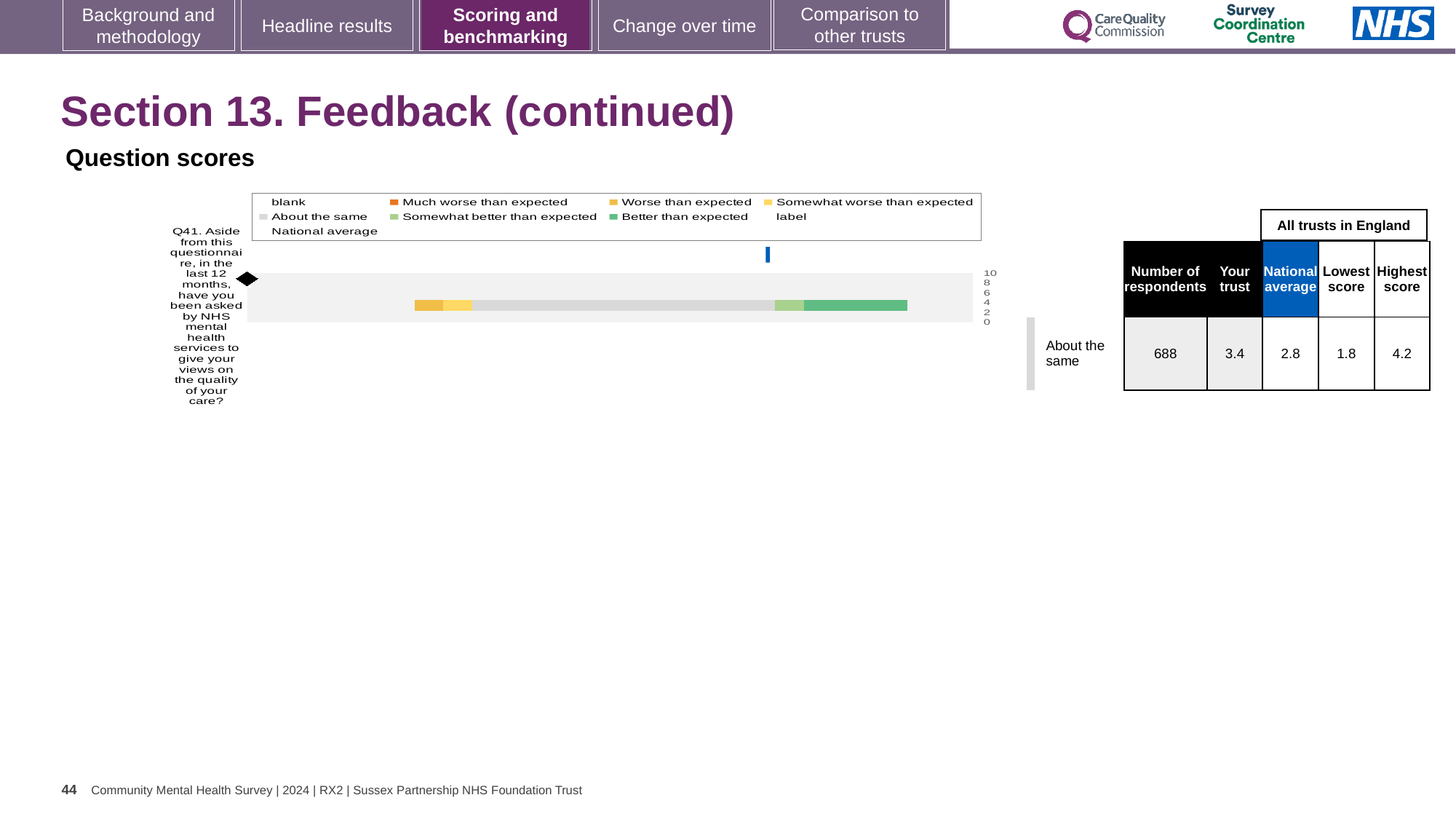
What kind of chart is shown on the slide? bar chart In the table next to the chart, what is the difference between the highest score and the lowest score for Q41? 2.4 Which legend category occupies the widest segment of the stacked bar? About the same In the table next to the chart, is the 'Your trust' score higher or lower than the national average for Q41? higher In the table next to the chart, how many respondents answered Q41? 688 In the table next to the chart, what is the national average score for Q41? 2.8 How many question categories are plotted in the bar chart? 1 Which question number is plotted in the bar chart? Q41 What colour is used for 'Better than expected' in the legend? green How many entries does the chart legend list? 9 Is the segment for 'Better than expected' wider or narrower than the segment for 'Worse than expected'? wider In the table next to the chart, what is the 'Your trust' score for Q41? 3.4